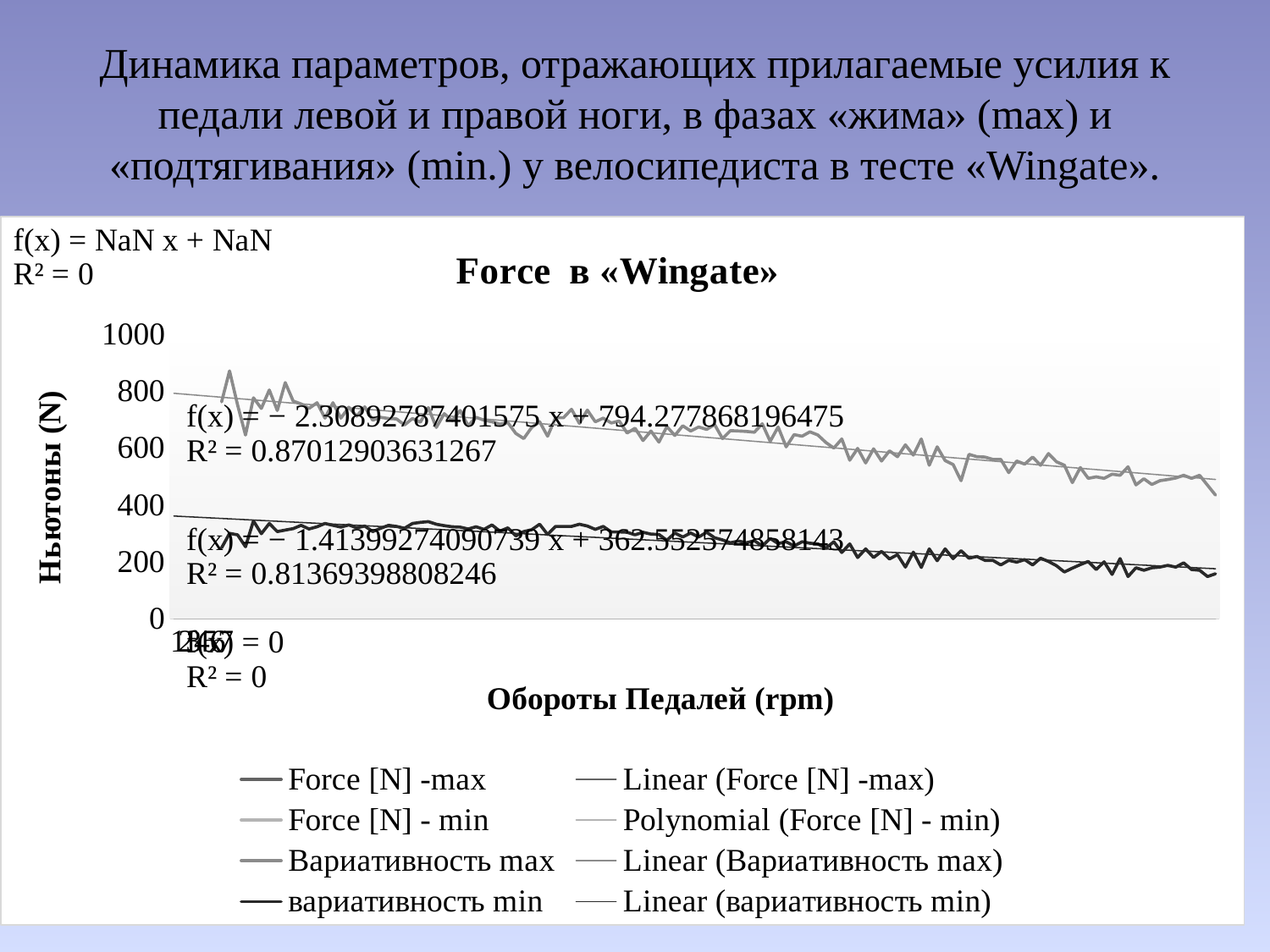
What is the highest tick value shown on the vertical axis? 1000 What R² value is printed for the trend line with the equation f(x) = − 2.30892787401575 x + 794.277868196475? 0.87012903631267 What kind of chart is shown on the slide? line chart Is the value of the upper data line at the right end of the chart greater or less than 600? less What is the label of the vertical axis of the chart? Ньютоны (N) Which of the two plotted data lines has larger values throughout the chart, the upper one or the lower one? the upper one Do the values of the lower data line rise or fall along the x axis? fall What R² value is printed for the trend line with the equation f(x) = − 1.41399274090739 x + 362.552574858143? 0.81369398808246 What is the title of the chart? Force в «Wingate» How many entries does the chart legend list? 8 Do the values of the upper data line rise or fall along the x axis? fall Is the value of the lower data line at the left end of the chart greater or less than 400? less